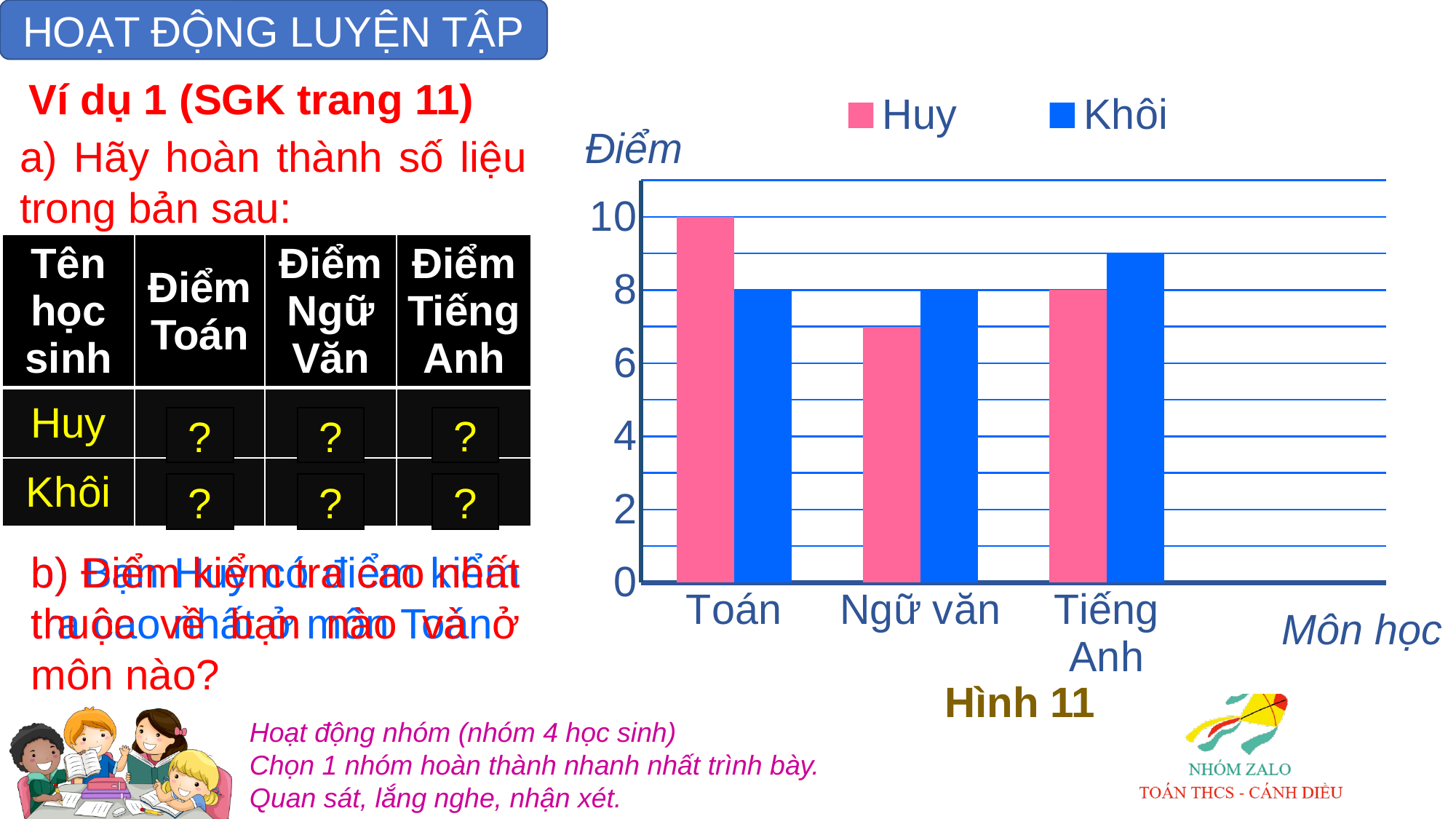
What is Huy's score in Toán? 10 What is the difference between Huy's and Khôi's scores in Toán? 2 Is Huy's score in Ngữ văn greater or less than 8? less How many subjects (categories) are shown on the x axis? 3 What kind of chart is shown on the slide? bar chart What is Khôi's score in Ngữ văn? 8 Is Khôi's score in Tiếng Anh greater or less than 8? greater In which subject does Huy have the highest score? Toán Who has the higher score in Ngữ văn, Huy or Khôi? Khôi What is Khôi's score in Toán? 8 How many series does the legend list? 2 What is Huy's score in Tiếng Anh? 8